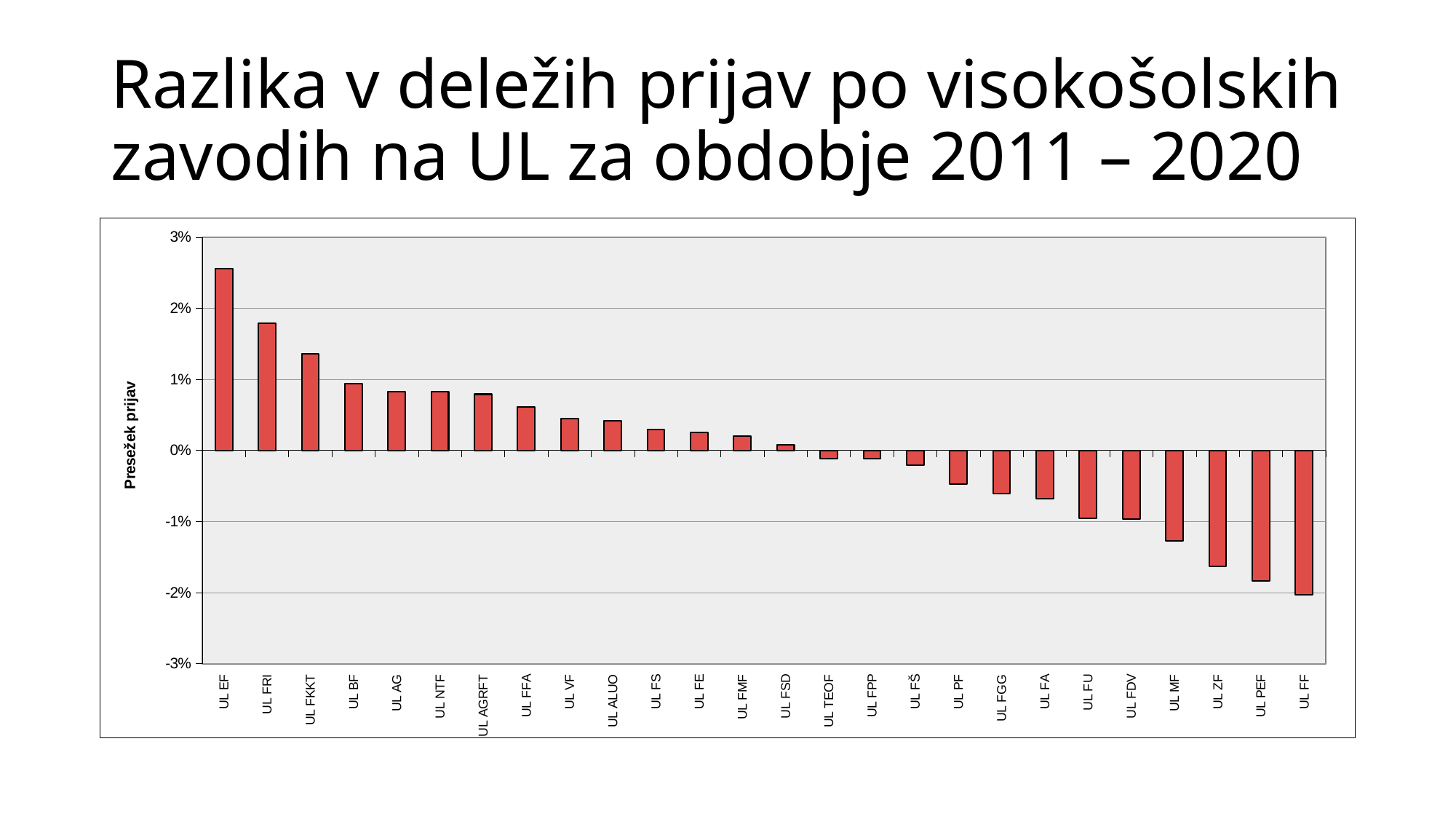
Which is larger, the value for UL BF or the value for UL FFA? UL BF Which category has the highest value in the chart? UL EF Which category has the lowest value in the chart? UL FF What is the title of the vertical axis? Presežek prijav What kind of chart is shown on the slide? bar chart Is the value for UL MF greater or less than -1%? less How many categories are plotted in the chart? 26 Do the values rise or fall moving from left to right along the x axis? fall Is the value for UL FKKT greater or less than 1%? greater Is the value for UL EF greater or less than 2%? greater